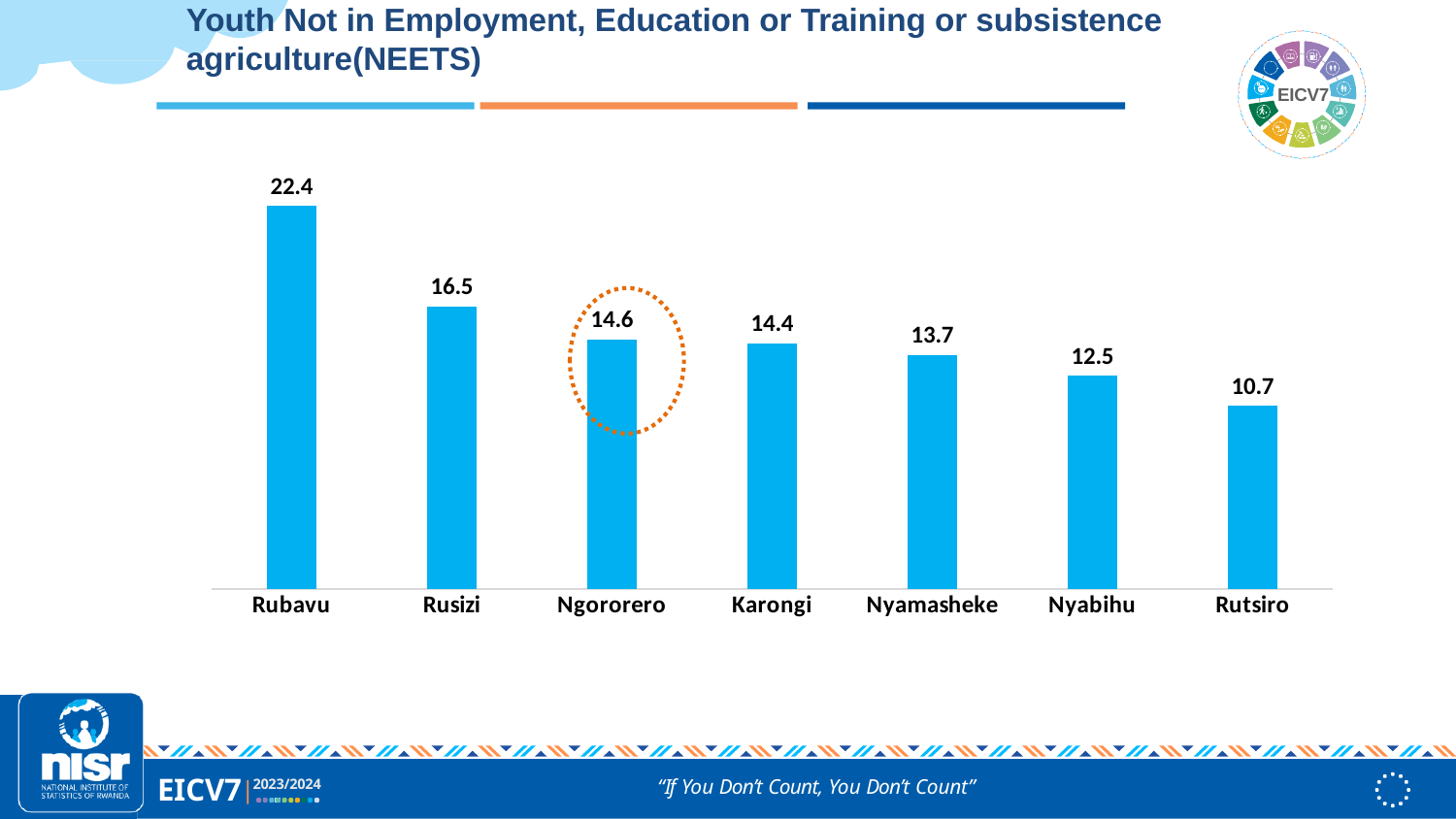
How many districts are shown on the chart? 7 What kind of chart is shown on the slide? Bar chart Which district's bar is highlighted with a dotted orange circle? Ngororero What is the value for Nyabihu? 12.5 What is the value for Ngororero? 14.6 Which district has the highest value? Rubavu Do the values rise or fall from left to right across the districts? Fall What is the difference between the values for Rubavu and Rusizi? 5.9 What is the difference between the values for Nyamasheke and Rutsiro? 3.0 Which is larger, the value for Karongi or the value for Nyabihu? Karongi Which district has the lowest value? Rutsiro What is the value for Rubavu? 22.4